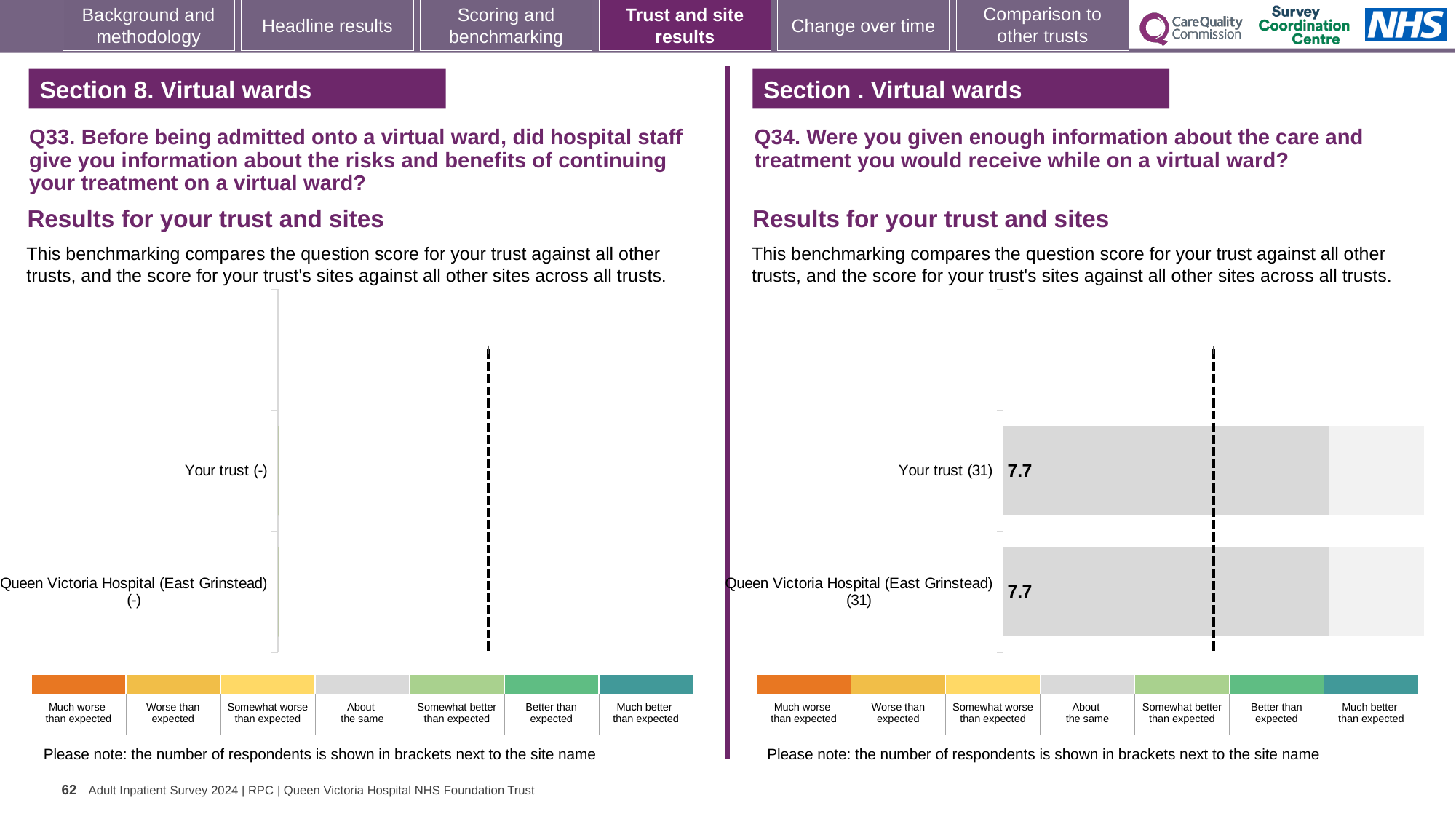
On the Q34 chart (right), what is the score for Your trust? 7.7 How many categories (rows) are plotted on the Q34 chart (right)? 2 What kind of chart is the Q34 chart on the right of the slide? Bar chart How many benchmark bands are shown in the colour key below the Q34 chart (right)? 7 On the Q34 chart (right), is the score for Your trust the same as the score for Queen Victoria Hospital (East Grinstead)? Yes On the Q34 chart (right), what is the score for Queen Victoria Hospital (East Grinstead)? 7.7 How many categories (rows) are listed on the Q33 chart (left)? 2 On the Q33 chart (left), what is shown in brackets next to Your trust? - On the Q34 chart (right), what is the difference between the score for Your trust and the score for Queen Victoria Hospital (East Grinstead)? 0 On the Q34 chart (right), how many respondents are shown in brackets next to Your trust? 31 On the Q34 chart (right), how many respondents are shown in brackets next to Queen Victoria Hospital (East Grinstead)? 31